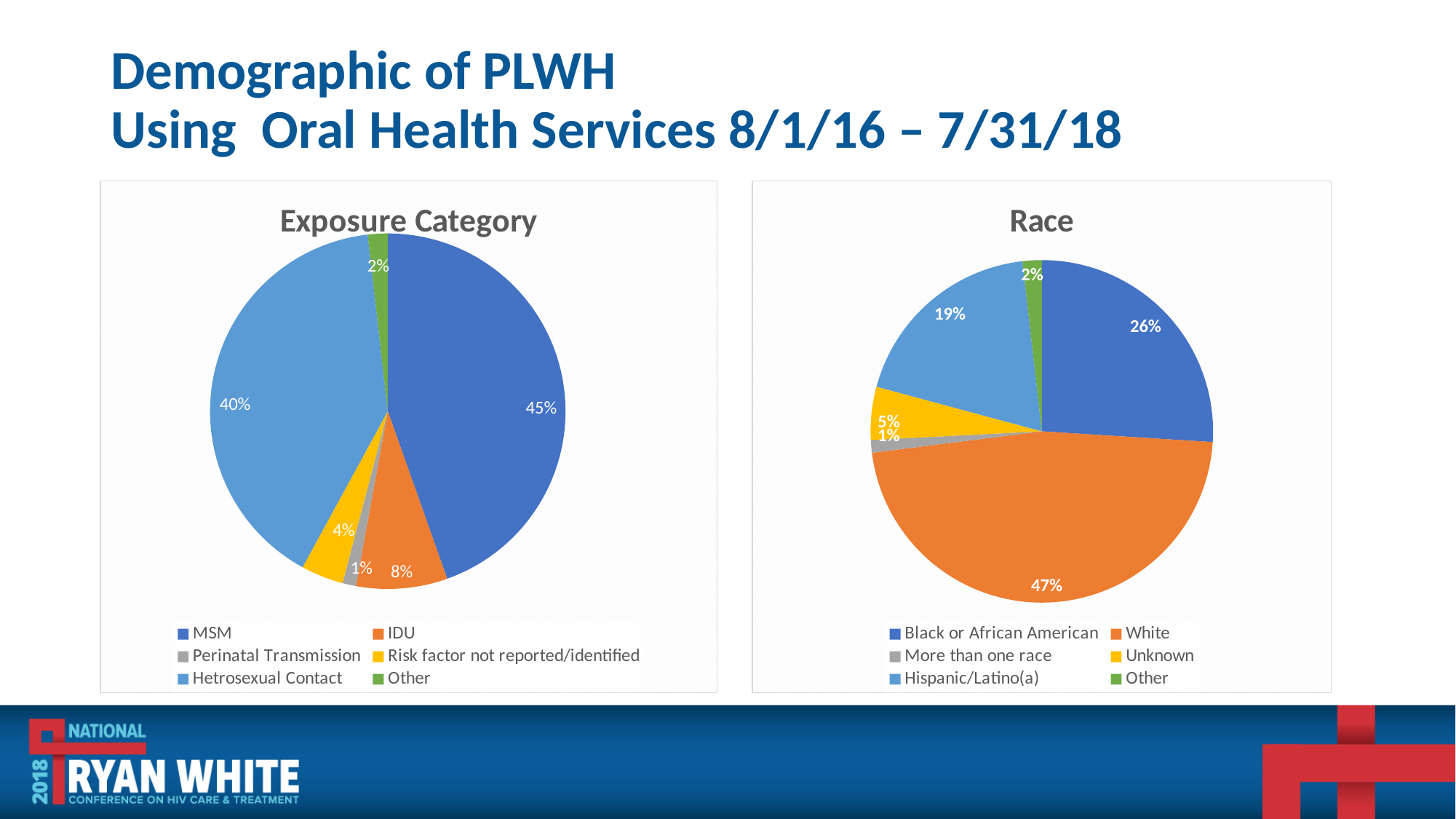
In the Exposure Category chart, which category has the largest share? MSM In the Exposure Category chart, how many categories does the legend list? 6 In the Race chart, what is the difference between the White and Black or African American shares? 21% In the Exposure Category chart, what is the difference between the MSM and Hetrosexual Contact shares? 5% In the Race chart, which category has the largest share? White In the Race chart, which is larger, Black or African American or Hispanic/Latino(a)? Black or African American In the Exposure Category chart, what share is Hetrosexual Contact? 40% In the Race chart, what share is White? 47% In the Exposure Category chart, what share is MSM? 45% What type of chart is the Race chart? Pie chart In the Race chart, what share is Hispanic/Latino(a)? 19% In the Exposure Category chart, what share is IDU? 8%